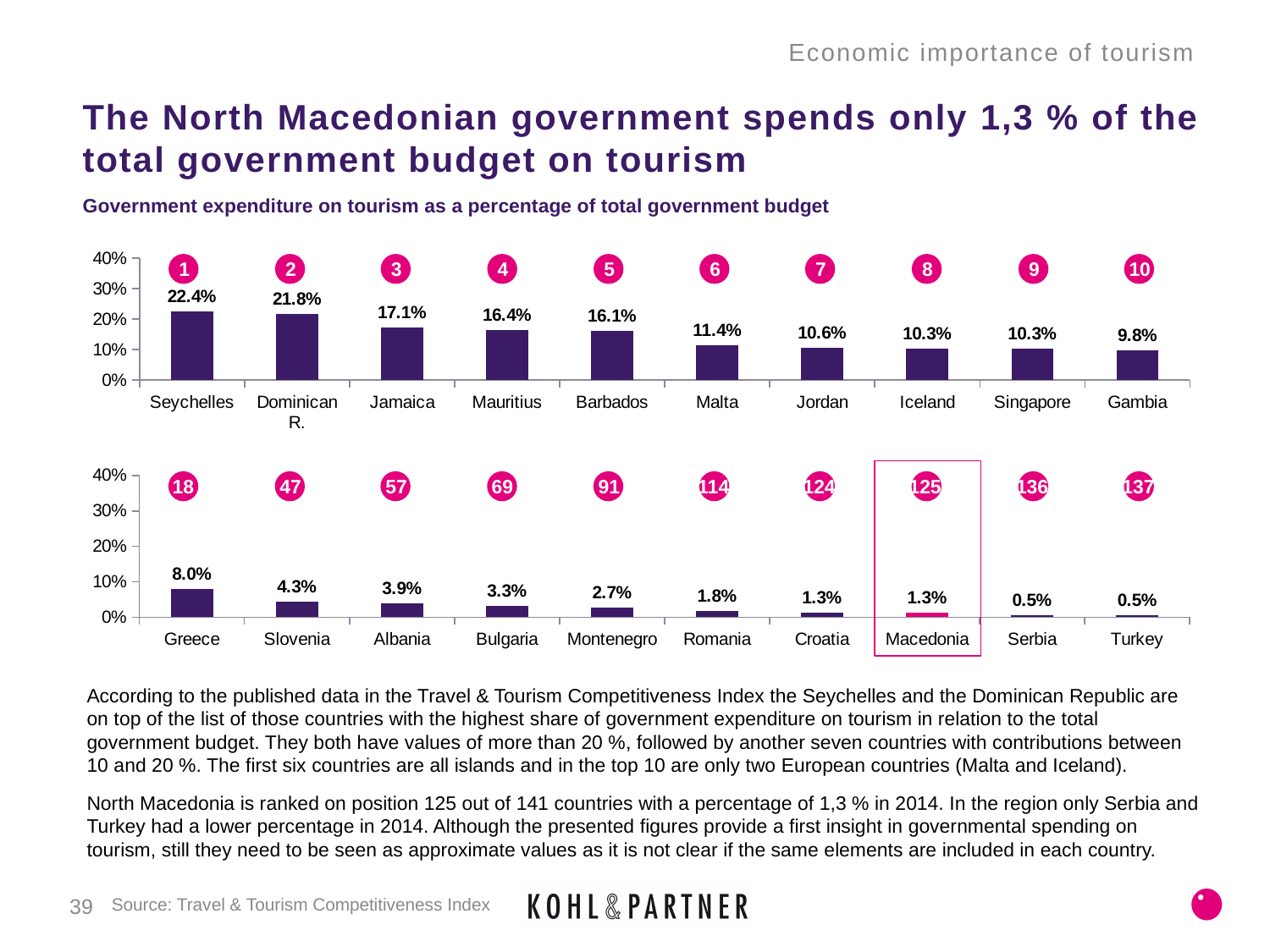
In the bottom chart, what is the value for Greece? 8.0% In the bottom chart, what is the value for Macedonia? 1.3% In the top chart, which country has the highest value? Seychelles In the bottom chart, which country has the highest value? Greece In the bottom chart, which is larger, the value for Slovenia or the value for Albania? Slovenia In the top chart, which country has the lowest value? Gambia How many countries are shown in the bottom chart? 10 In the top chart, what is the difference between the values for Seychelles and Dominican R.? 0.6% What kind of chart is the top chart? Bar chart In the top chart, what is the value for Malta? 11.4% In the top chart, what is the value for Seychelles? 22.4% In the bottom chart, do the values rise or fall from left to right? Fall